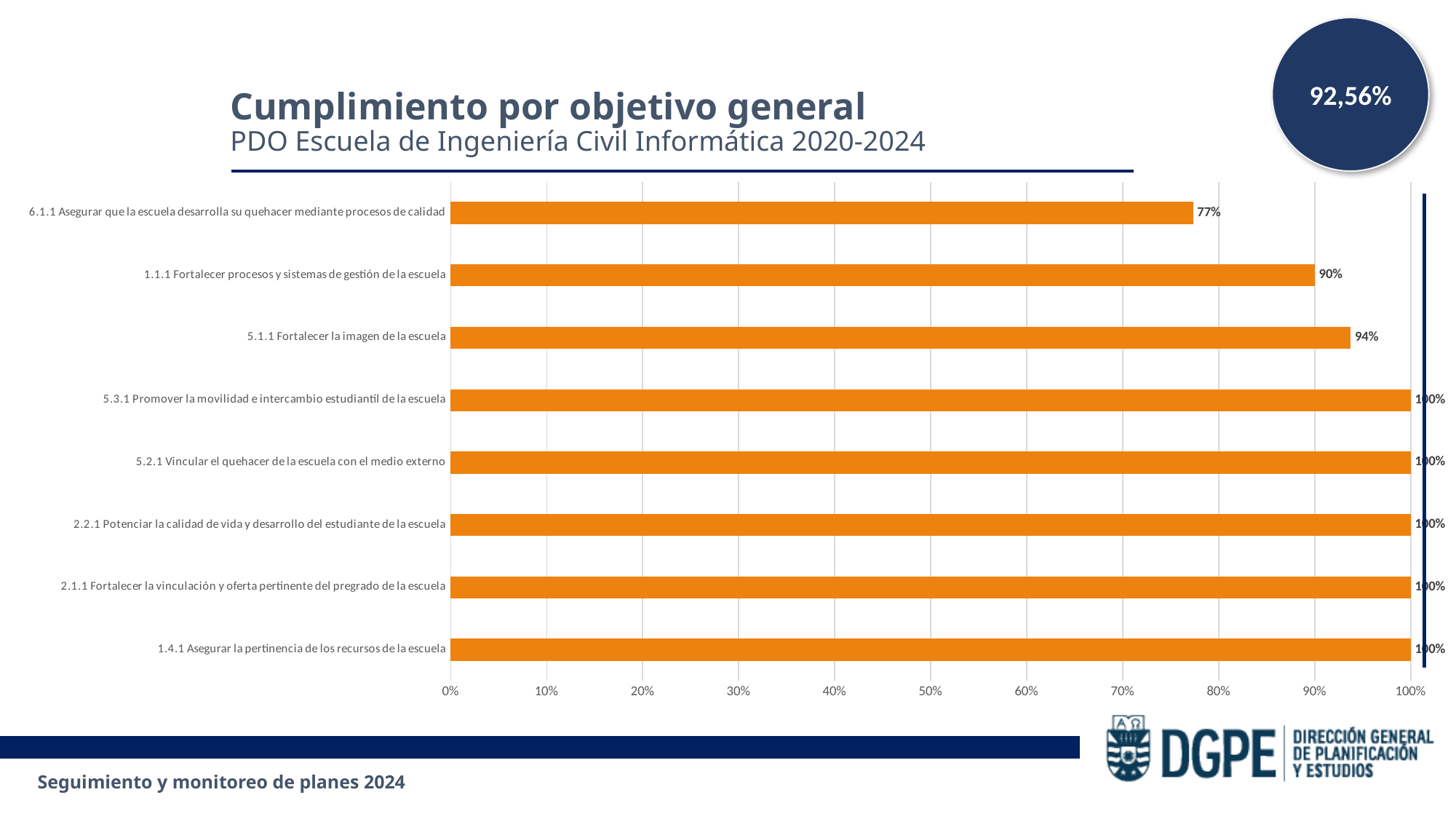
What is the difference between the values for 5.1.1 Fortalecer la imagen de la escuela and 6.1.1 Asegurar que la escuela desarrolla su quehacer mediante procesos de calidad? 17% How many objectives have a value of 100%? 5 What kind of chart is shown on the slide? Bar chart What is the value for 1.1.1 Fortalecer procesos y sistemas de gestión de la escuela? 90% What is the value for 5.3.1 Promover la movilidad e intercambio estudiantil de la escuela? 100% Which is larger, the value for 1.1.1 Fortalecer procesos y sistemas de gestión de la escuela or the value for 5.1.1 Fortalecer la imagen de la escuela? 5.1.1 Fortalecer la imagen de la escuela What is the difference between the values for 1.1.1 Fortalecer procesos y sistemas de gestión de la escuela and 6.1.1 Asegurar que la escuela desarrolla su quehacer mediante procesos de calidad? 13% Is the value for 6.1.1 Asegurar que la escuela desarrolla su quehacer mediante procesos de calidad greater or less than 80%? less What is the value for 5.1.1 Fortalecer la imagen de la escuela? 94% Which objective has the lowest value? 6.1.1 Asegurar que la escuela desarrolla su quehacer mediante procesos de calidad What is the value for 6.1.1 Asegurar que la escuela desarrolla su quehacer mediante procesos de calidad? 77% How many objectives are shown in the chart? 8